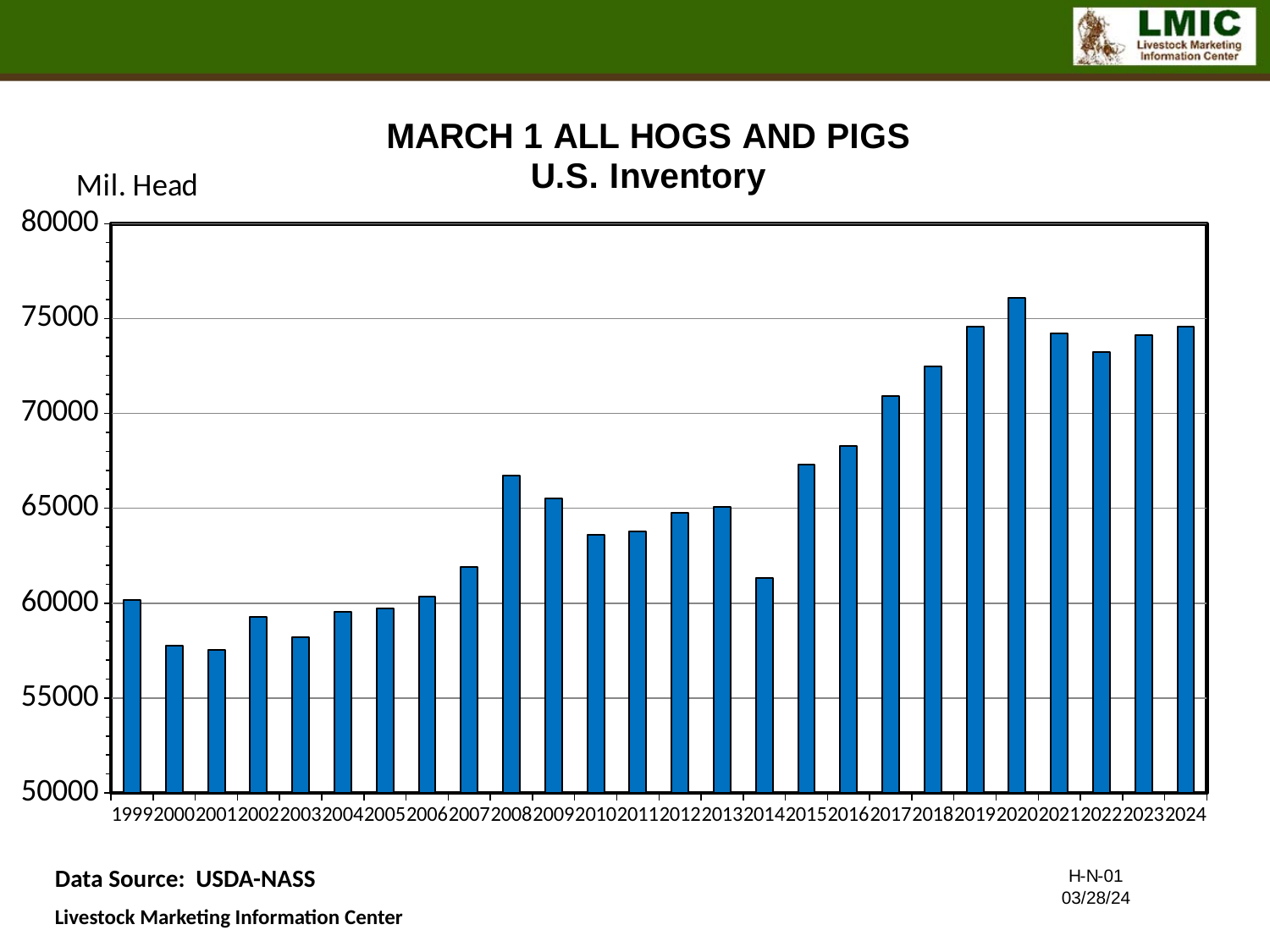
Is the value for 2003 greater or less than 60000? less Is the value for 2022 greater or less than 75000? less What kind of chart is shown on the slide? bar chart Which year has the highest March 1 hogs and pigs inventory? 2020 Which is larger, the value for 2020 or the value for 2024? 2020 Which is larger, the value for 2008 or the value for 2009? 2008 How many years (bars) are plotted on the chart? 26 Is the value for 2014 greater or less than 60000? greater Overall, do the values rise or fall from 1999 to 2024? rise What unit label is shown on the vertical axis of the chart? Mil. Head